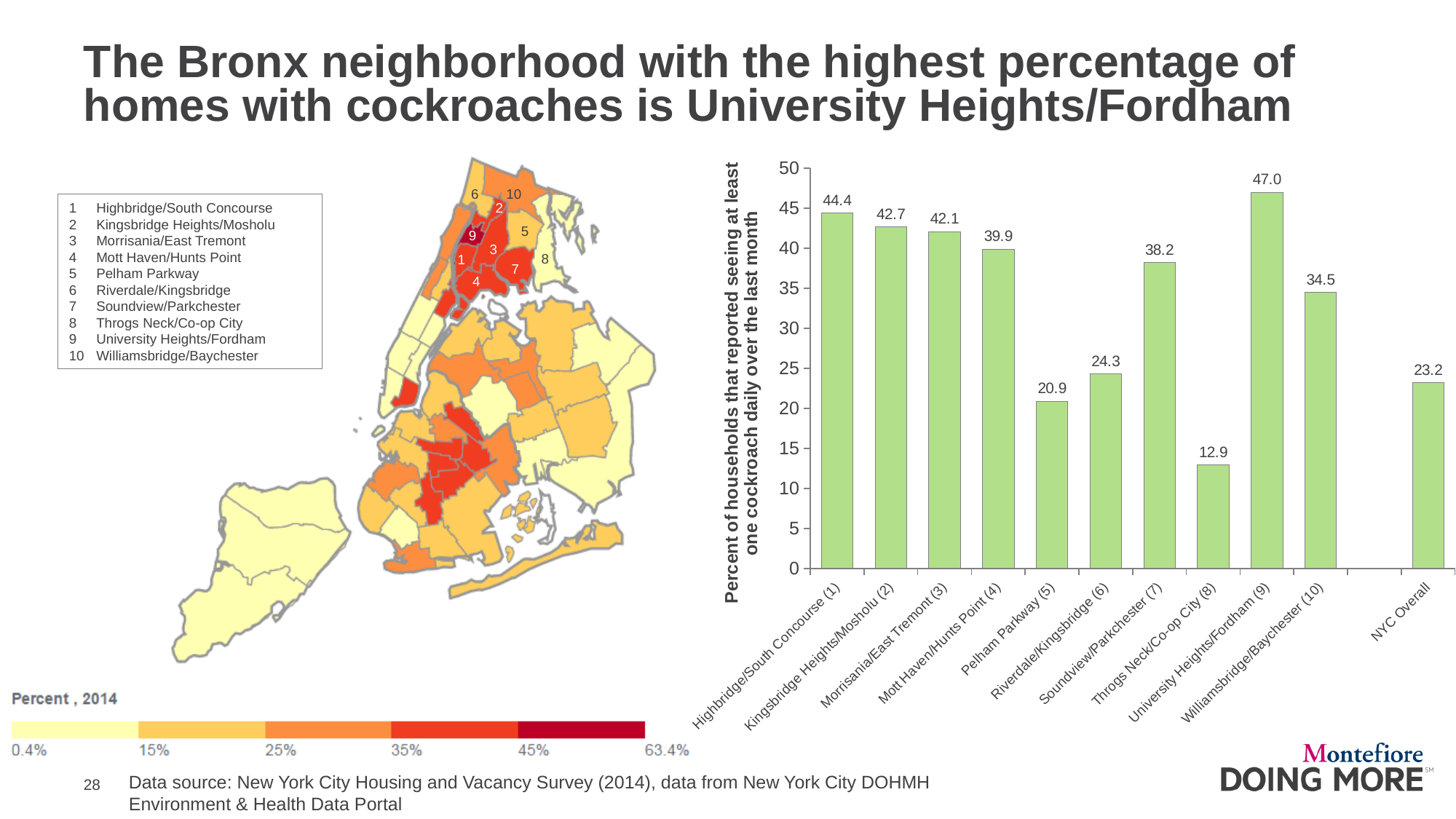
What is the value for Throgs Neck/Co-op City (8) in the bar chart? 12.9 What is the value for University Heights/Fordham (9) in the bar chart? 47.0 What is the y-axis label of the bar chart? Percent of households that reported seeing at least one cockroach daily over the last month What kind of chart is shown on the right side of the slide? bar chart What is the difference between the values for University Heights/Fordham (9) and NYC Overall in the bar chart? 23.8 Which category has the lowest value in the bar chart? Throgs Neck/Co-op City (8) Which category has the highest value in the bar chart? University Heights/Fordham (9) Is the value for Soundview/Parkchester (7) in the bar chart greater or less than 35? greater What is the difference between the values for Highbridge/South Concourse (1) and Kingsbridge Heights/Mosholu (2) in the bar chart? 1.7 Which is larger in the bar chart: Pelham Parkway (5) or Riverdale/Kingsbridge (6)? Riverdale/Kingsbridge (6) What is the value for NYC Overall in the bar chart? 23.2 How many bars are shown in the bar chart? 11